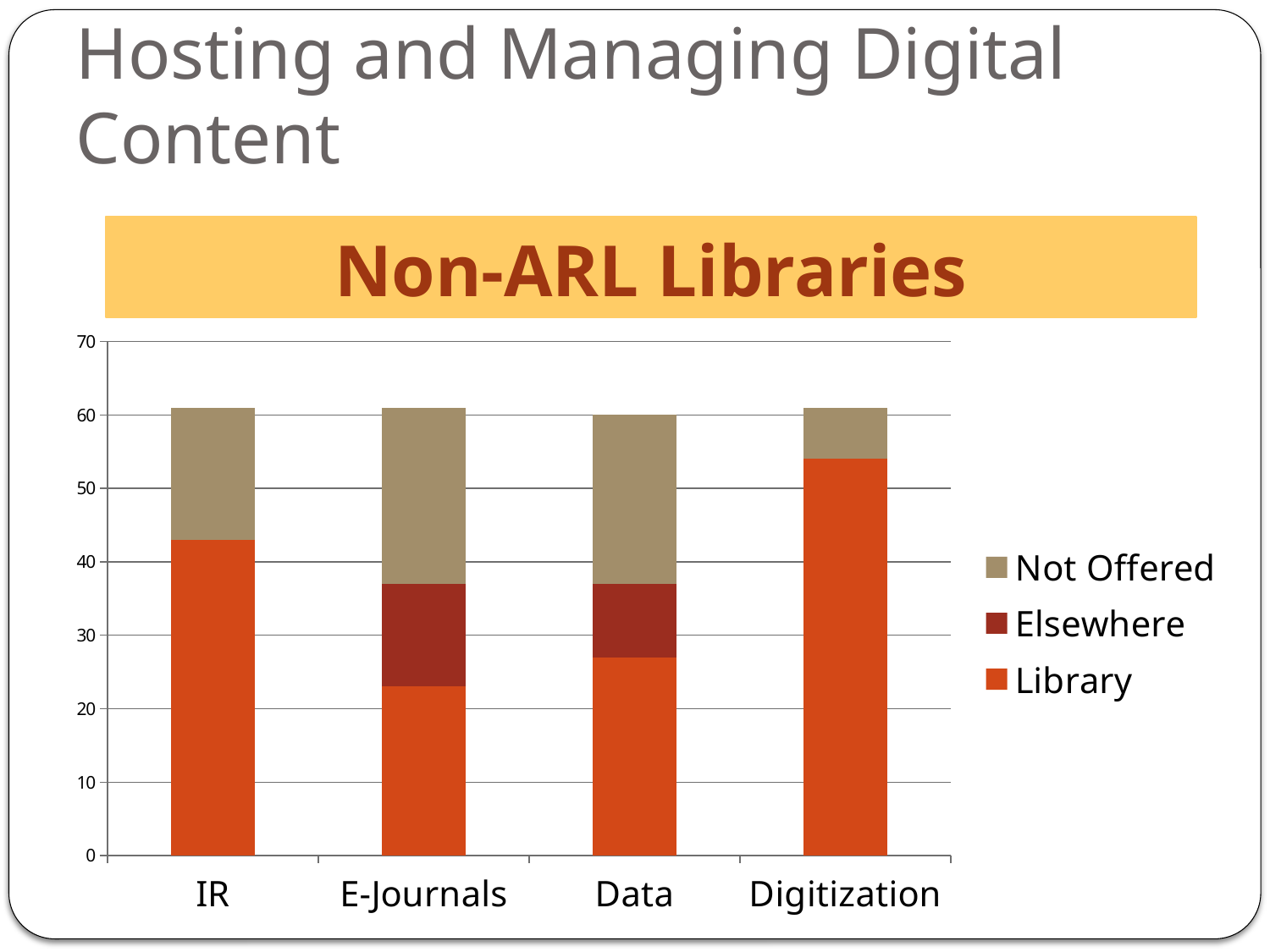
How many categories are shown on the x axis of the chart? 4 What kind of chart is shown on the slide? Stacked bar chart What heading appears in the banner above the chart? Non-ARL Libraries Is the Library value for IR greater or less than 40? greater Which category has the smallest Not Offered segment? Digitization How many series does the chart's legend list? 3 Which category has the largest Library segment? Digitization Which is larger, the Elsewhere segment for E-Journals or the Elsewhere segment for Data? E-Journals Which is larger, the Library value for IR or the Library value for Data? IR Which category has the smallest Library segment? E-Journals Is the Library value for Digitization greater or less than 50? greater Is the Library value for E-Journals greater or less than 30? less